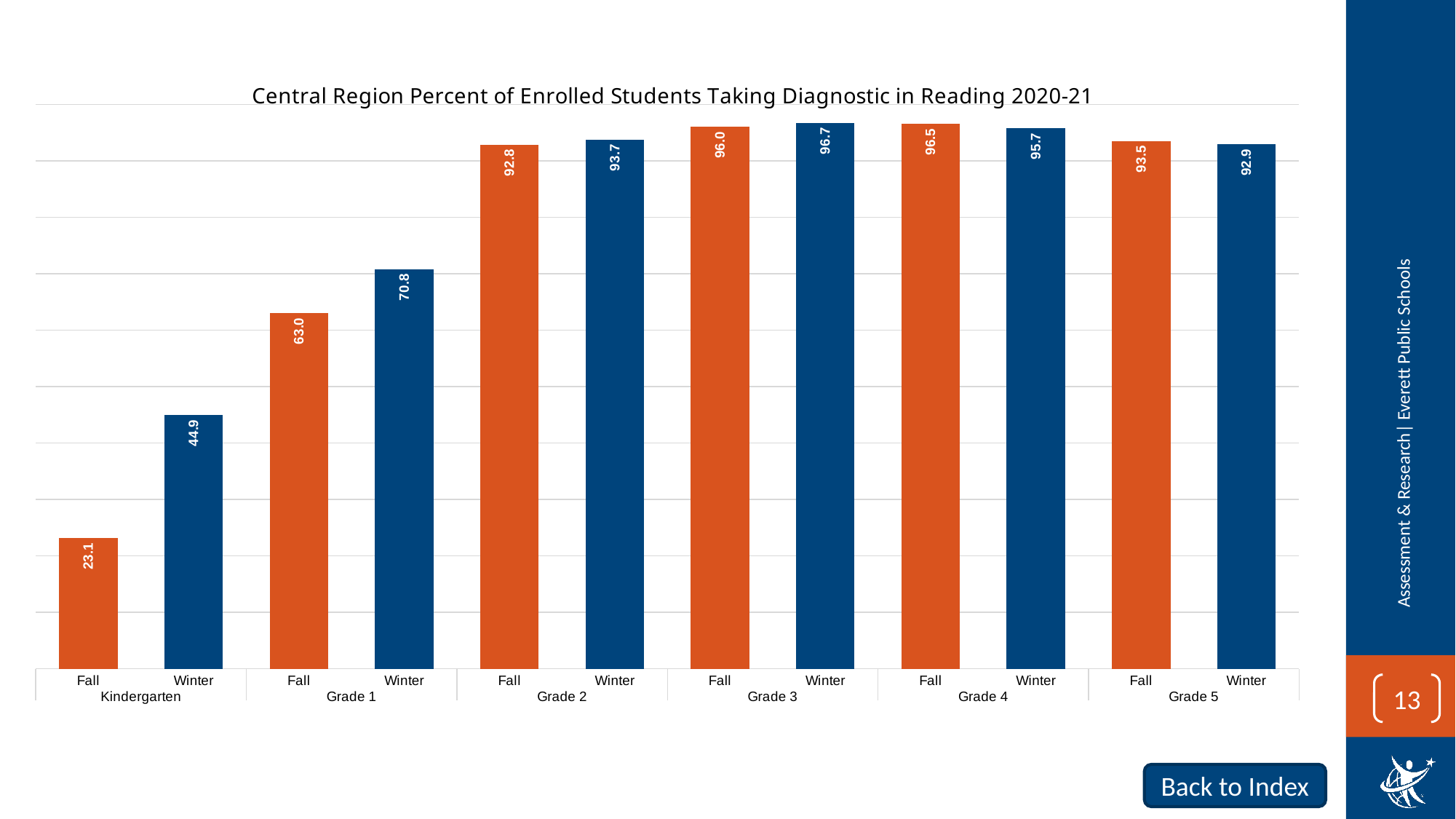
What is the difference between the Winter and Fall values for Kindergarten? 21.8 What is the Fall value for Kindergarten? 23.1 Which bar has the highest value in the chart? Grade 3 Winter What is the Winter value for Grade 1? 70.8 What is the title of the chart? Central Region Percent of Enrolled Students Taking Diagnostic in Reading 2020-21 Which bar has the lowest value in the chart? Kindergarten Fall What is the Winter value for Grade 5? 92.9 What is the difference between the Winter and Fall values for Grade 1? 7.8 What is the Fall value for Grade 4? 96.5 What kind of chart is shown on the slide? Bar chart How many grade-level groups are shown on the x axis? 6 Which is larger for Grade 4, the Fall value or the Winter value? Fall